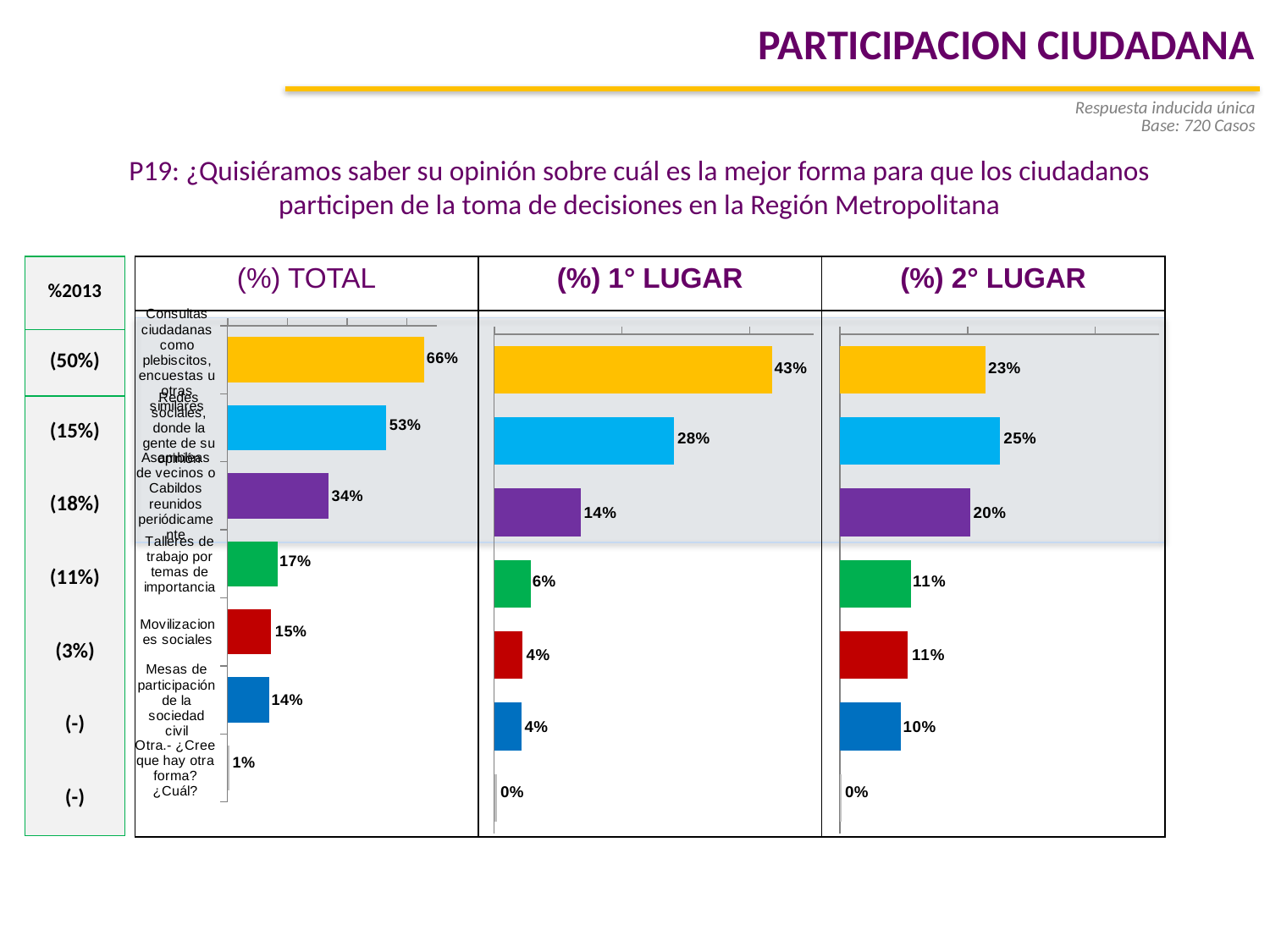
How many categories are shown in the (%) TOTAL chart? 7 In the (%) 1° LUGAR chart, what is the value for Movilizaciones sociales? 4% In the (%) TOTAL chart, which is larger: Talleres de trabajo por temas de importancia or Movilizaciones sociales? Talleres de trabajo por temas de importancia In the (%) 1° LUGAR chart, what is the value for Redes sociales? 28% In the (%) 2° LUGAR chart, what is the value for Asambleas de vecinos o Cabildos reunidos periódicamente? 20% In the (%) 2° LUGAR chart, which category has the highest value? Redes sociales In the (%) 2° LUGAR chart, what is the value for Mesas de participación de la sociedad civil? 10% In the (%) TOTAL chart, what is the value for Consultas ciudadanas como plebiscitos, encuestas u otras similares? 66% In the (%) 1° LUGAR chart, what is the difference between Consultas ciudadanas and Redes sociales? 15% In the (%) TOTAL chart, which category has the lowest value? Otra.- ¿Cree que hay otra forma? ¿Cuál? How many charts are shown on the slide? 3 What kind of chart is the (%) 1° LUGAR chart? Bar chart